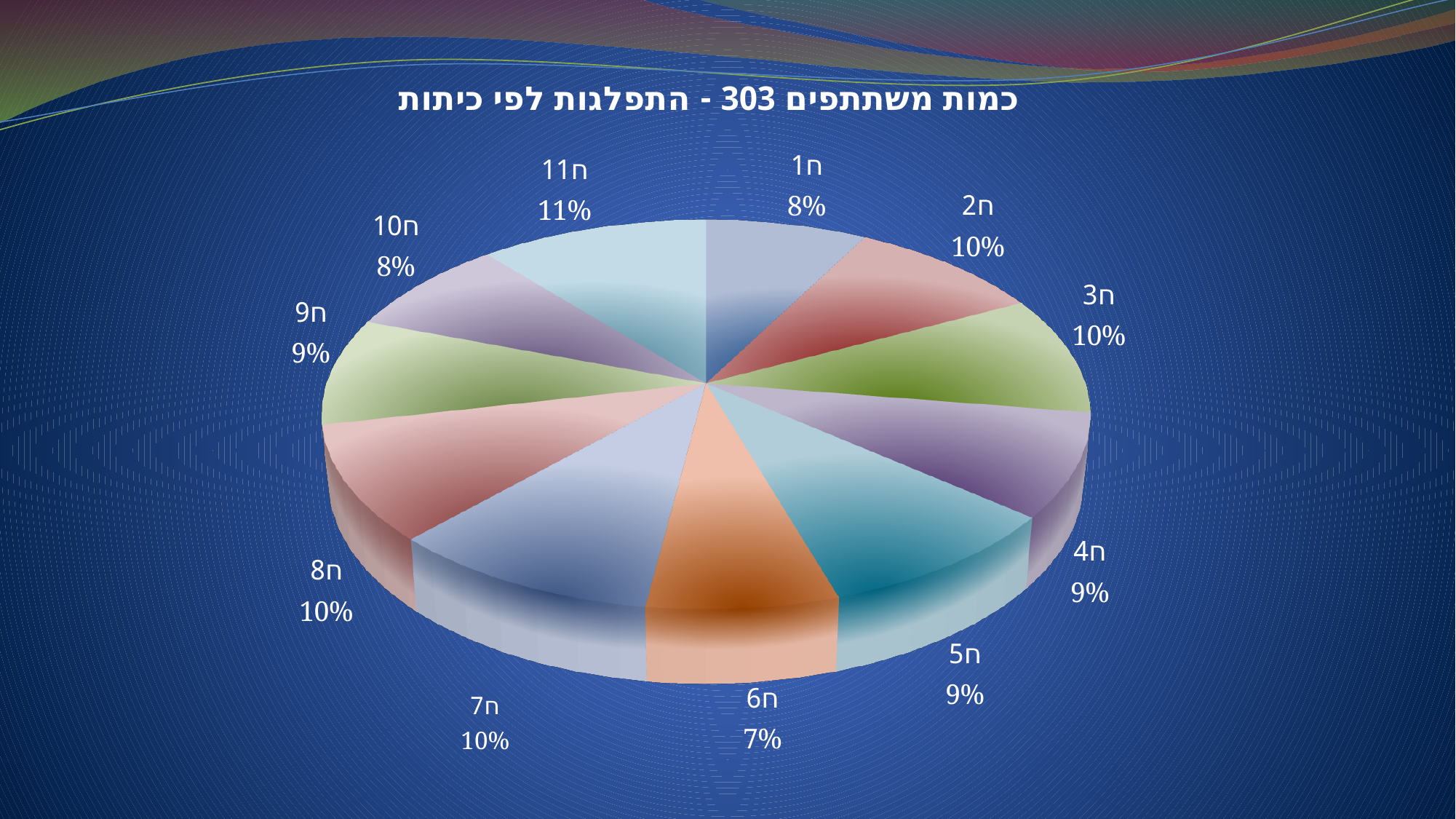
Which class has the largest share of the pie? ח11 What share of the pie does ח6 have? 7% What share of the pie does ח1 have? 8% What kind of chart is shown on the slide? pie chart Which class has the smallest share of the pie? ח6 What is the difference between the shares of ח7 and ח1? 2% How many slices does the pie chart have? 11 What share of the pie does ח11 have? 11% What is the title of the chart? כמות משתתפים 303 - התפלגות לפי כיתות Which has a larger share, ח2 or ח10? ח2 What is the difference between the shares of ח11 and ח6? 4%